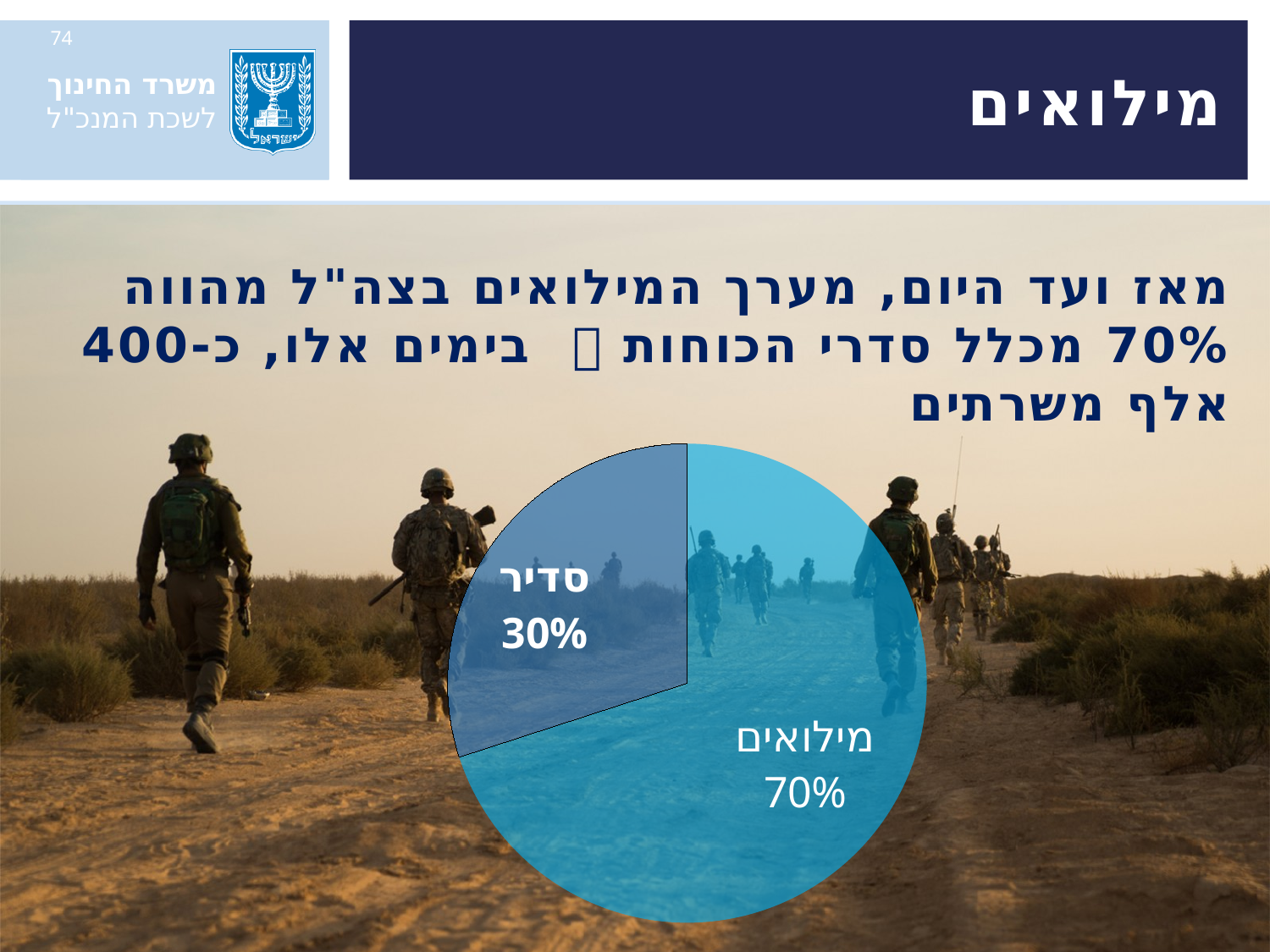
What is the value printed on the larger slice of the pie chart? 70% What share of the pie does the מילואים slice represent? 70% Which slice of the pie chart is the largest? מילואים What is the total of the two slices shown in the pie chart? 100% What is the difference in percentage points between the מילואים slice and the סדיר slice? 40% How many slices does the pie chart have? 2 Which is larger, the מילואים slice or the סדיר slice? מילואים Which slice of the pie chart is the smallest? סדיר What is the value printed on the smaller slice of the pie chart? 30% What is the title shown in the header bar of the slide? מילואים What share of the pie does the סדיר slice represent? 30% What kind of chart is shown on the slide? pie chart